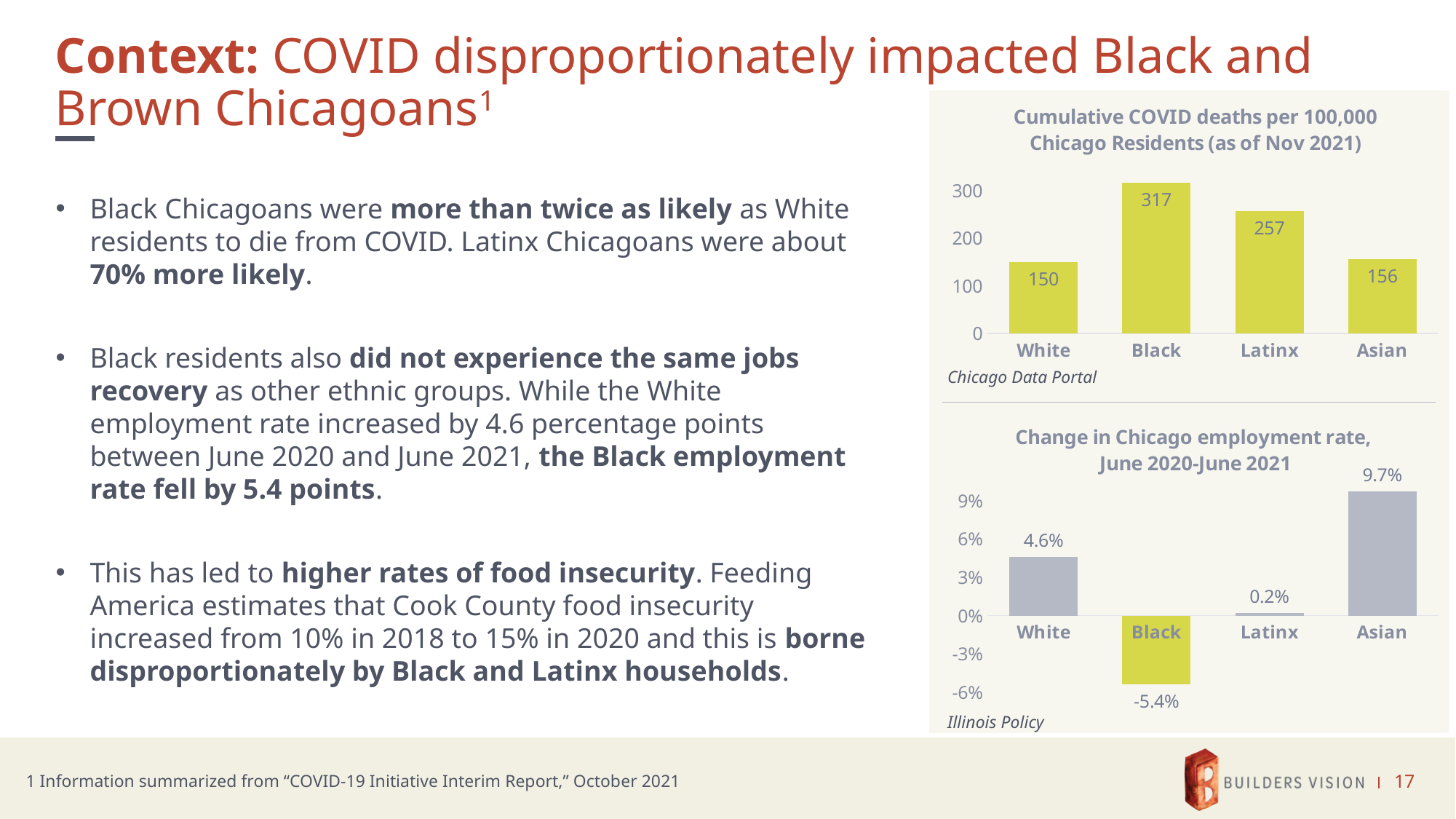
In the 'Cumulative COVID deaths per 100,000 Chicago Residents' chart, what is the difference between the Black and White values? 167 What type of chart is the 'Cumulative COVID deaths per 100,000 Chicago Residents' chart? Bar chart In the 'Cumulative COVID deaths per 100,000 Chicago Residents' chart, which group has the lowest value? White In the 'Cumulative COVID deaths per 100,000 Chicago Residents' chart, how many groups are shown? 4 In the 'Change in Chicago employment rate, June 2020-June 2021' chart, what is the difference between the Asian and White values? 5.1% In the 'Cumulative COVID deaths per 100,000 Chicago Residents' chart, what is the value for Black residents? 317 In the 'Change in Chicago employment rate, June 2020-June 2021' chart, what is the value for Black residents? -5.4% In the 'Change in Chicago employment rate, June 2020-June 2021' chart, what is the value for Asian residents? 9.7% In the 'Change in Chicago employment rate, June 2020-June 2021' chart, which group has the lowest value? Black In the 'Change in Chicago employment rate, June 2020-June 2021' chart, is the value for White larger or the value for Latinx? White In the 'Cumulative COVID deaths per 100,000 Chicago Residents' chart, which group has the highest value? Black What source is cited below the 'Cumulative COVID deaths per 100,000 Chicago Residents' chart? Chicago Data Portal